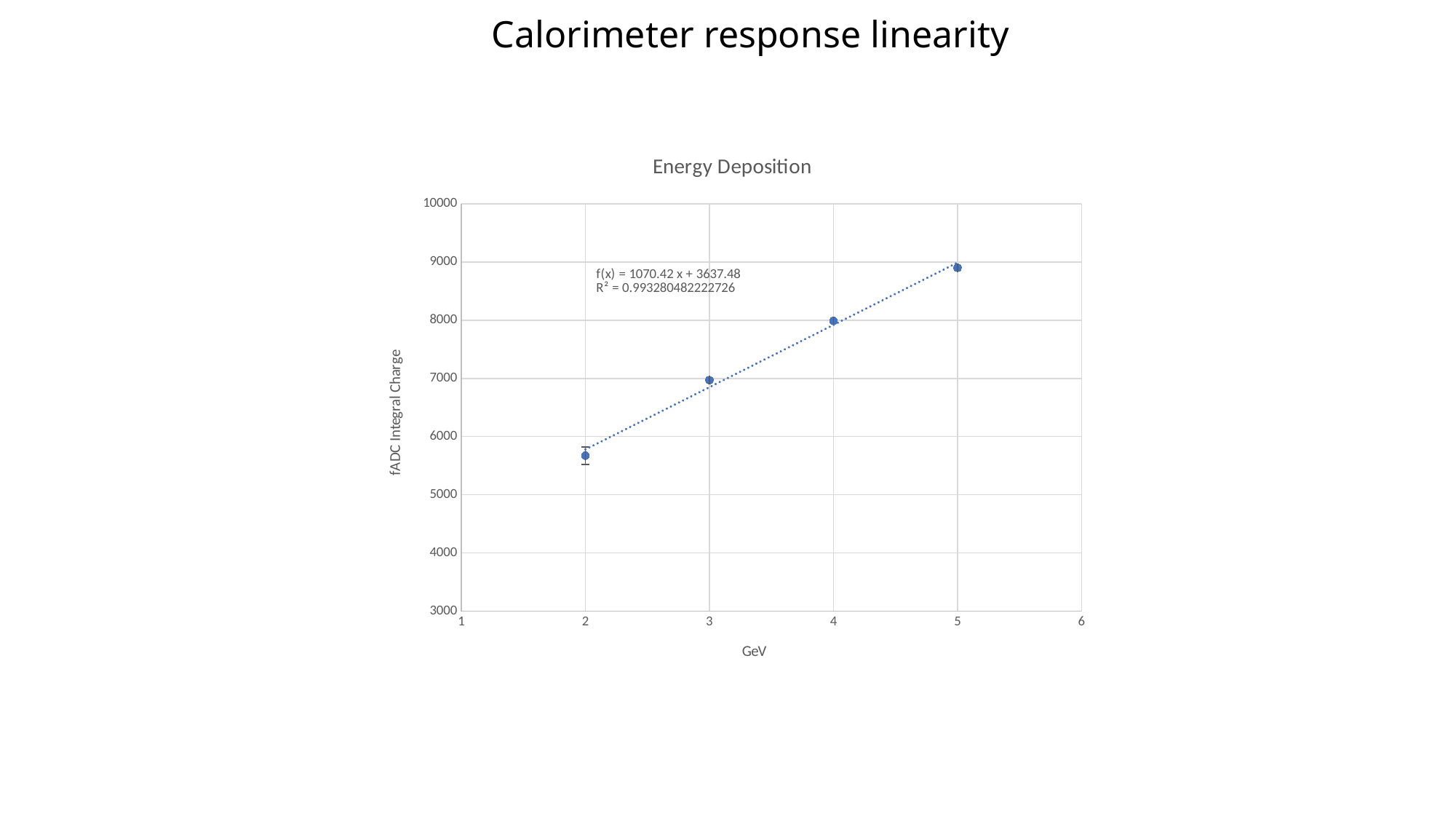
What kind of chart is shown on the slide? scatter chart At which GeV value is the fADC Integral Charge highest? 5 What is the slope of the fitted trendline equation shown on the chart? 1070.42 Do the fADC Integral Charge values rise or fall as GeV increases? rise How many data points are plotted in the Energy Deposition chart? 4 Is the fADC Integral Charge at 3 GeV greater or less than 6000? greater Is the fADC Integral Charge at 2 GeV greater or less than 6000? less Is the fADC Integral Charge at 5 GeV greater or less than 8000? greater At which GeV value is the fADC Integral Charge lowest? 2 What is the title of the chart? Energy Deposition Which has a larger fADC Integral Charge, the point at 3 GeV or the point at 4 GeV? 4 GeV What is the label of the y axis? fADC Integral Charge